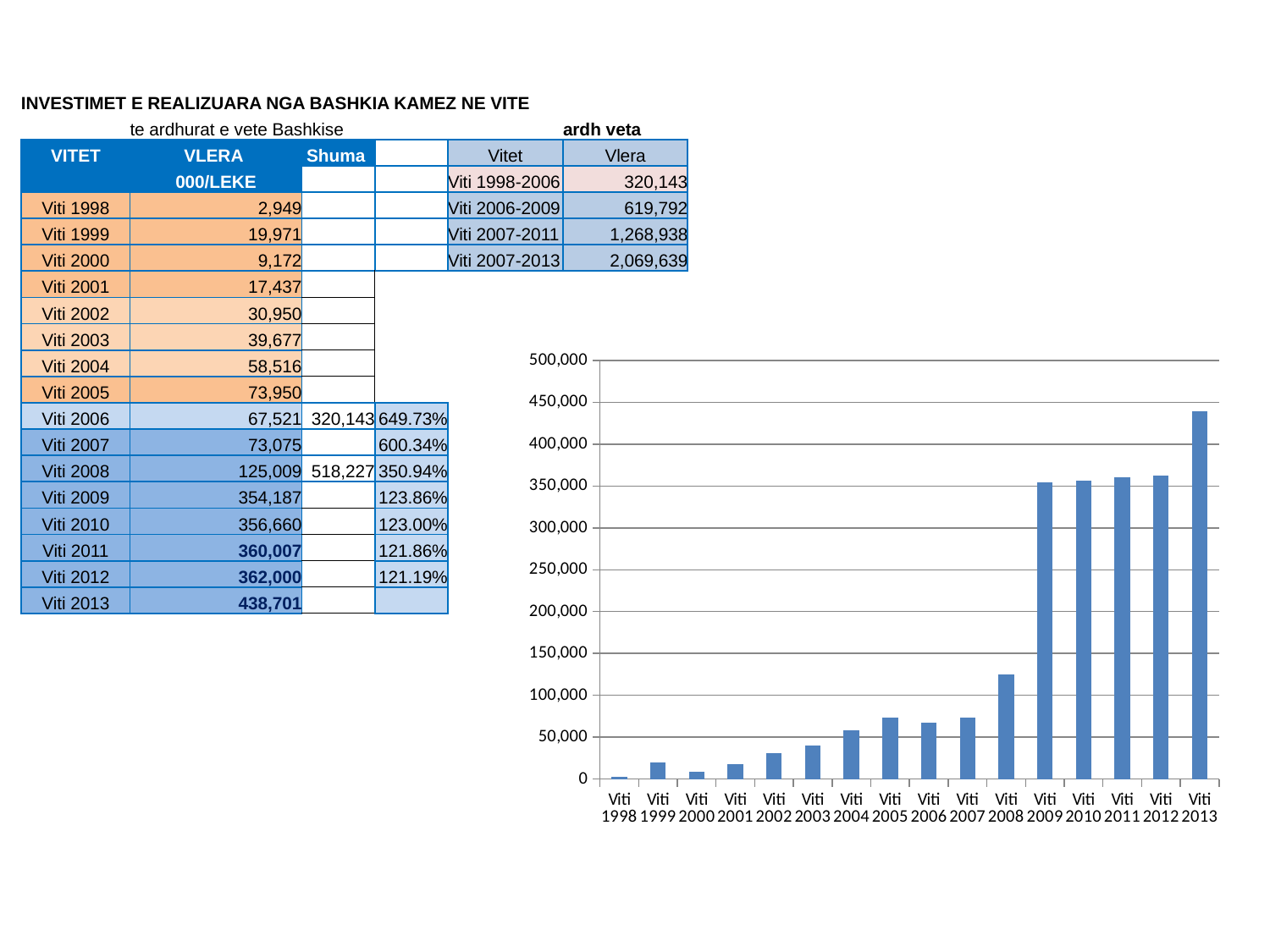
Which year has the highest bar in the chart? Viti 2013 What is the highest tick value shown on the chart's vertical axis? 500,000 How many years (bars) are plotted in the chart? 16 Which bar is taller in the chart, Viti 2003 or Viti 2004? Viti 2004 Is the value for Viti 2013 in the chart greater or less than 400,000? greater Is the value for Viti 2009 in the chart greater or less than 400,000? less Is the value for Viti 2008 in the chart greater or less than 100,000? greater Do the values in the chart generally rise or fall from Viti 1998 to Viti 2013? rise Which year has the lowest bar in the chart? Viti 1998 According to the table on the slide, what is the value (VLERA) for Viti 2013? 438,701 What kind of chart is shown on the slide? bar chart Which bar is taller in the chart, Viti 2008 or Viti 2009? Viti 2009